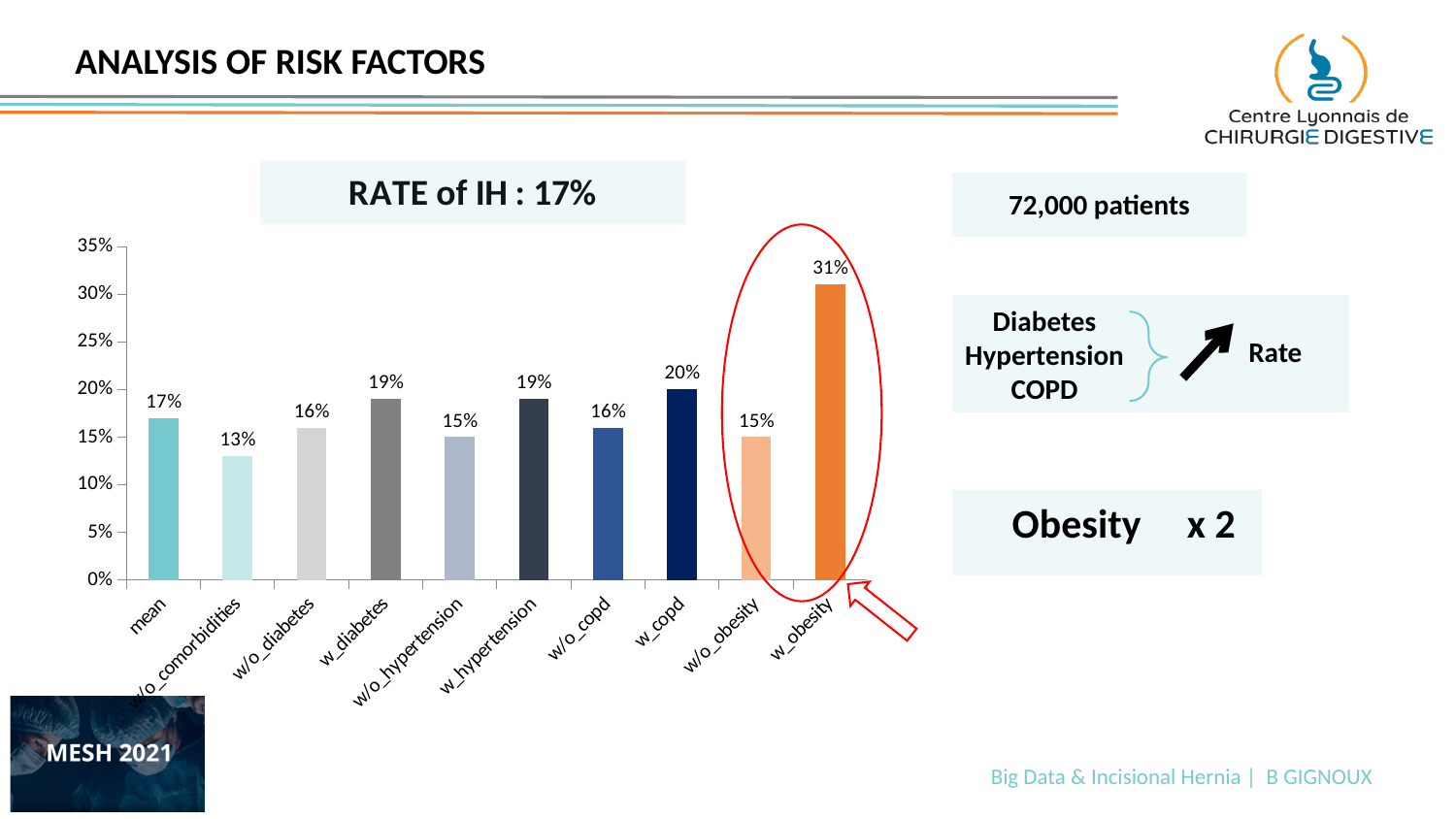
What is the value for w_copd? 20% What is the difference between the values for w_obesity and w/o_obesity? 16% What is the value for w_obesity? 31% Which category has the lowest value? w/o_comorbidities How many categories are shown on the x axis? 10 What is the difference between the values for w_diabetes and w/o_diabetes? 3% Which category has the highest value? w_obesity Which is larger, the value for w_copd or the value for w_hypertension? w_copd What is the title shown above the chart? RATE of IH : 17% What is the value for the mean category? 17% What kind of chart is shown on the slide? Bar chart What is the value for w/o_comorbidities? 13%